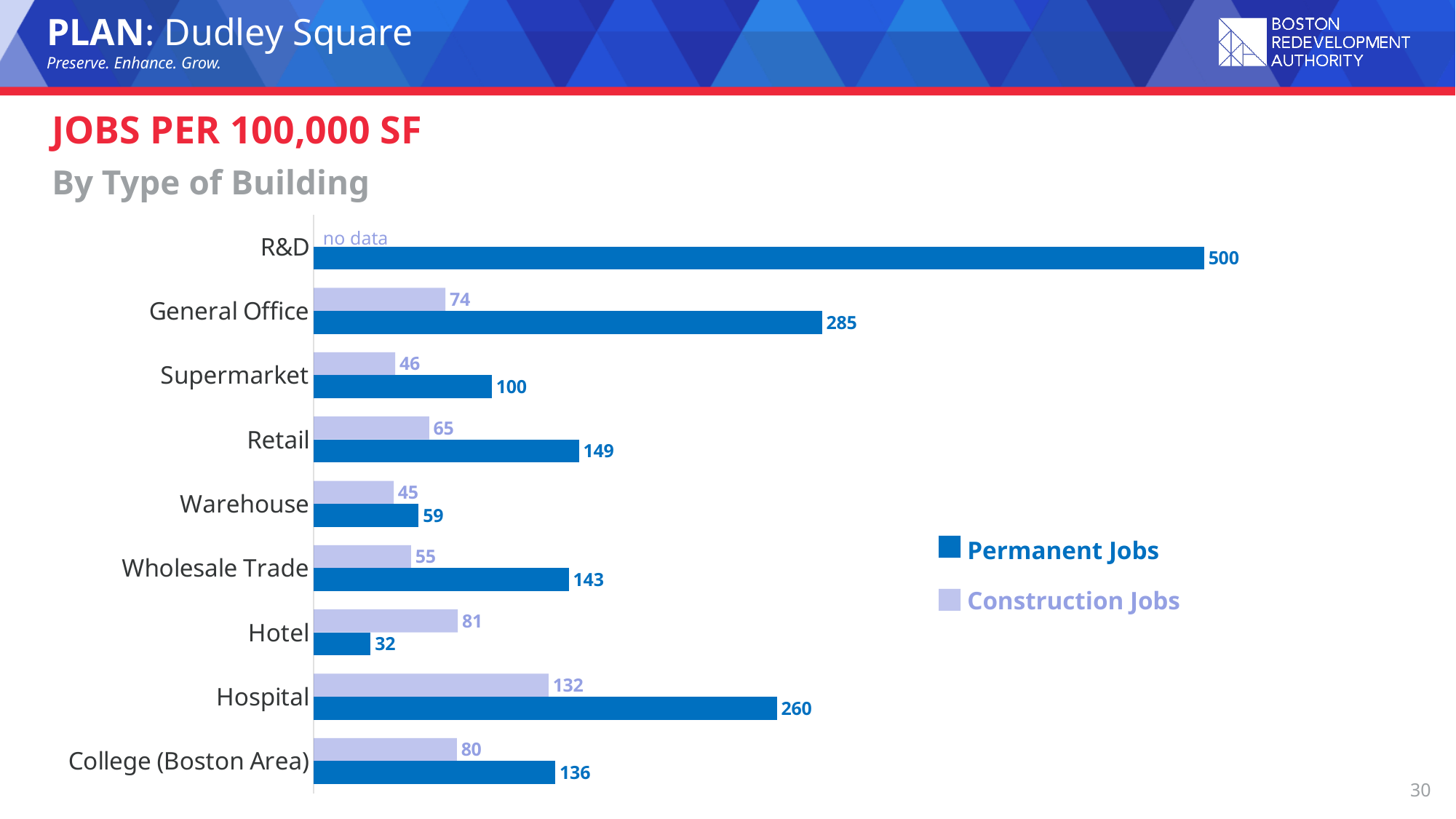
Which is larger for Hotel: Permanent Jobs or Construction Jobs? Construction Jobs What is the Construction Jobs value for Hospital? 132 What kind of chart is shown? Bar chart Which building type has the highest Construction Jobs value? Hospital What is the Permanent Jobs value for General Office? 285 How many building types are shown on the chart? 9 Which building type has the lowest Permanent Jobs value? Hotel What is the Permanent Jobs value for Hotel? 32 How many series does the legend list? 2 What is the difference between Permanent Jobs and Construction Jobs for Retail? 84 Which building type has the highest Permanent Jobs value? R&D What is shown for the Construction Jobs value of R&D? no data